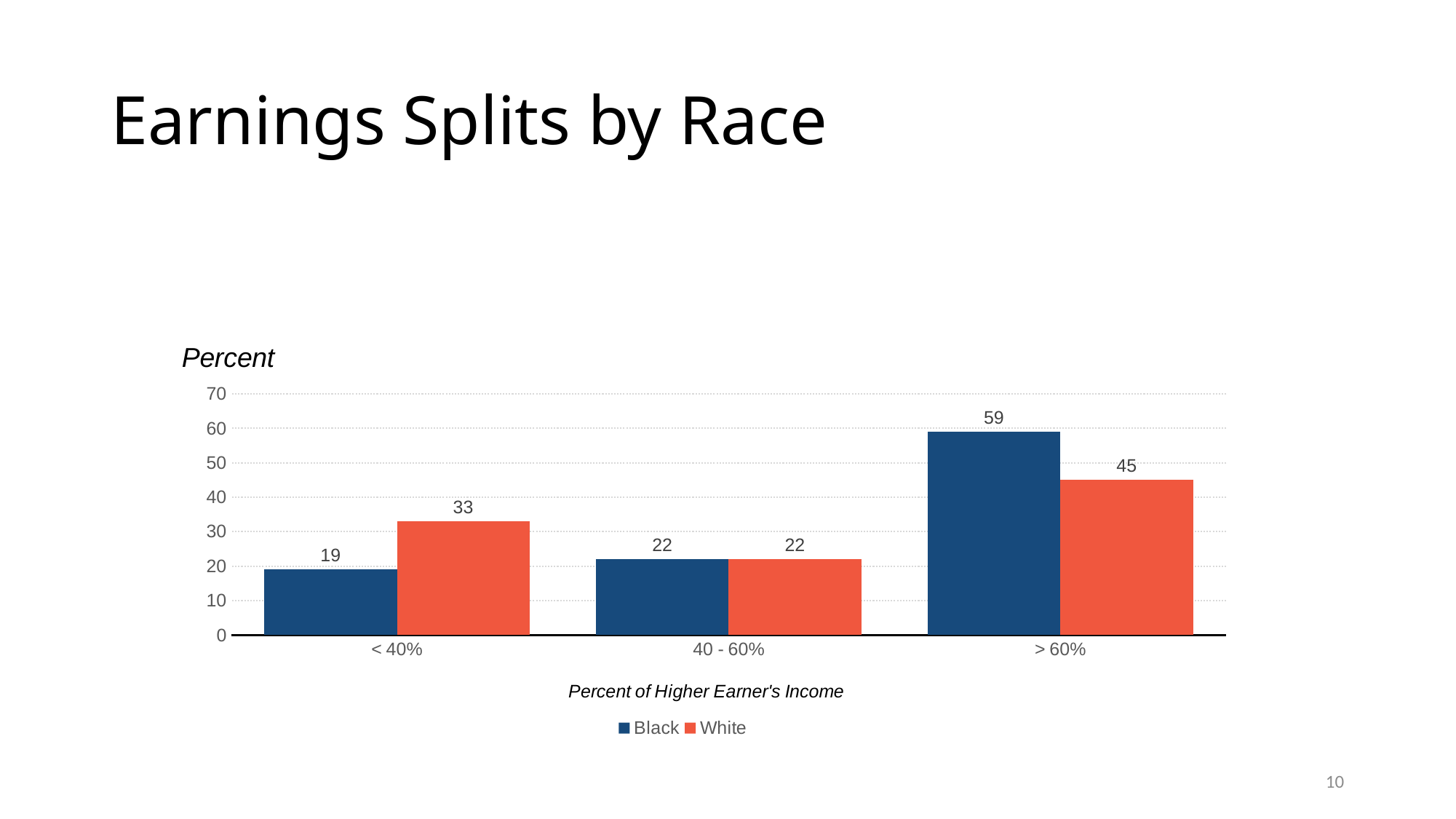
What is the value for Black in the > 60% category? 59 Which category has the highest value for the White series? > 60% What is the x-axis label of the chart? Percent of Higher Earner's Income Which category has the lowest value for the Black series? < 40% What is the value for White in the < 40% category? 33 How many series does the legend list? 2 What is the value for Black in the 40 - 60% category? 22 What is the difference between the White and Black values in the < 40% category? 14 What kind of chart is shown on the slide? Bar chart What is the difference between the Black and White values in the > 60% category? 14 How many categories are shown on the x axis? 3 In the < 40% category, which series has the larger value, Black or White? White